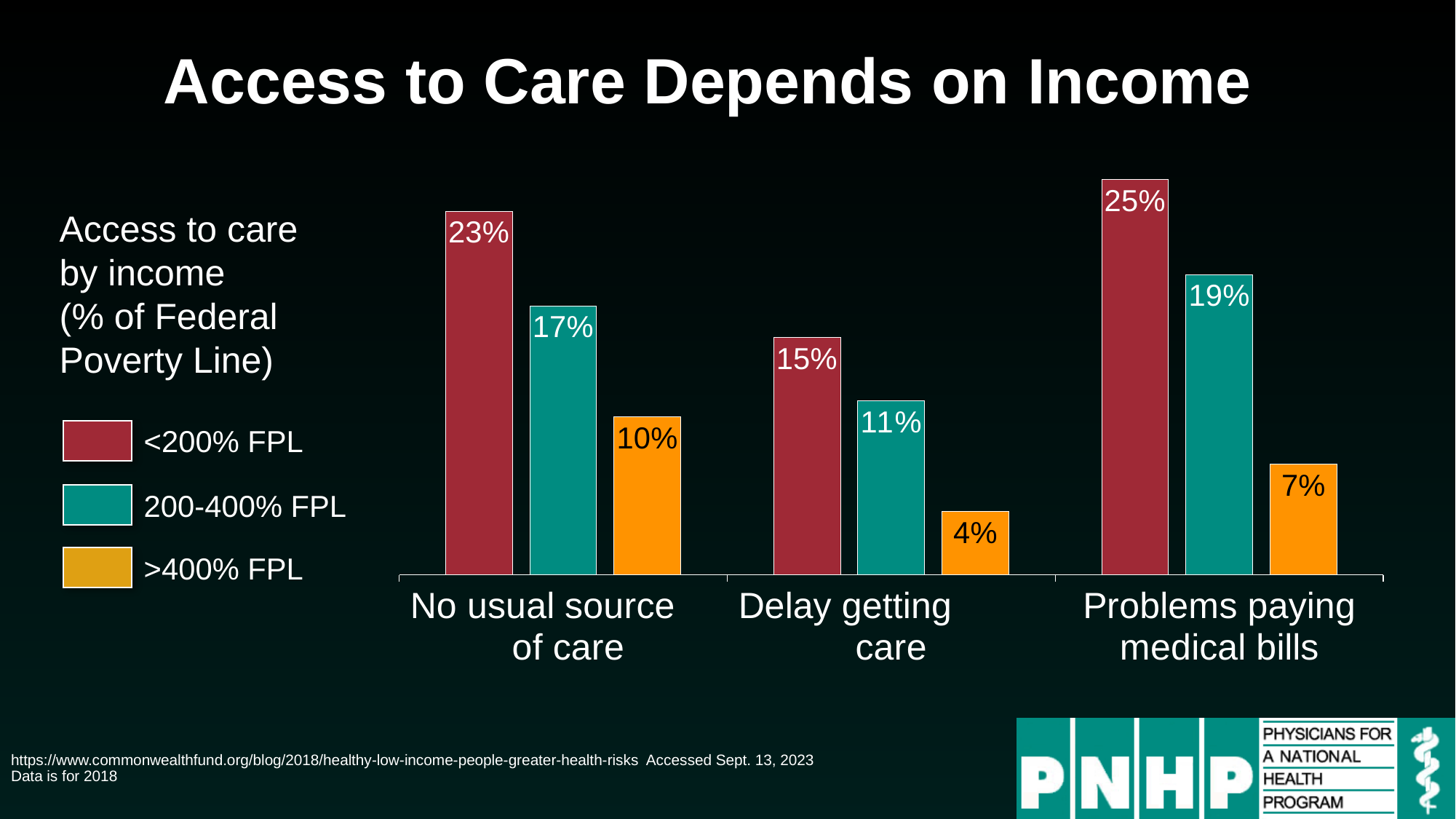
What is the difference between the <200% FPL and >400% FPL values in the 'Problems paying medical bills' category? 18% What is the value for 200-400% FPL in the 'Problems paying medical bills' category? 19% How many categories are shown on the x axis? 3 Which legend entry is shown in orange? >400% FPL What kind of chart is shown on the slide? Bar chart Which category has the lowest value for the >400% FPL series? Delay getting care How many series does the legend list? 3 What is the value for <200% FPL in the 'No usual source of care' category? 23% What is the difference between the 200-400% FPL and >400% FPL values in the 'No usual source of care' category? 7% Which is larger: the 200-400% FPL value for 'Delay getting care' or the >400% FPL value for 'No usual source of care'? 200-400% FPL value for 'Delay getting care' Which category has the highest value for the <200% FPL series? Problems paying medical bills What is the value for >400% FPL in the 'Delay getting care' category? 4%